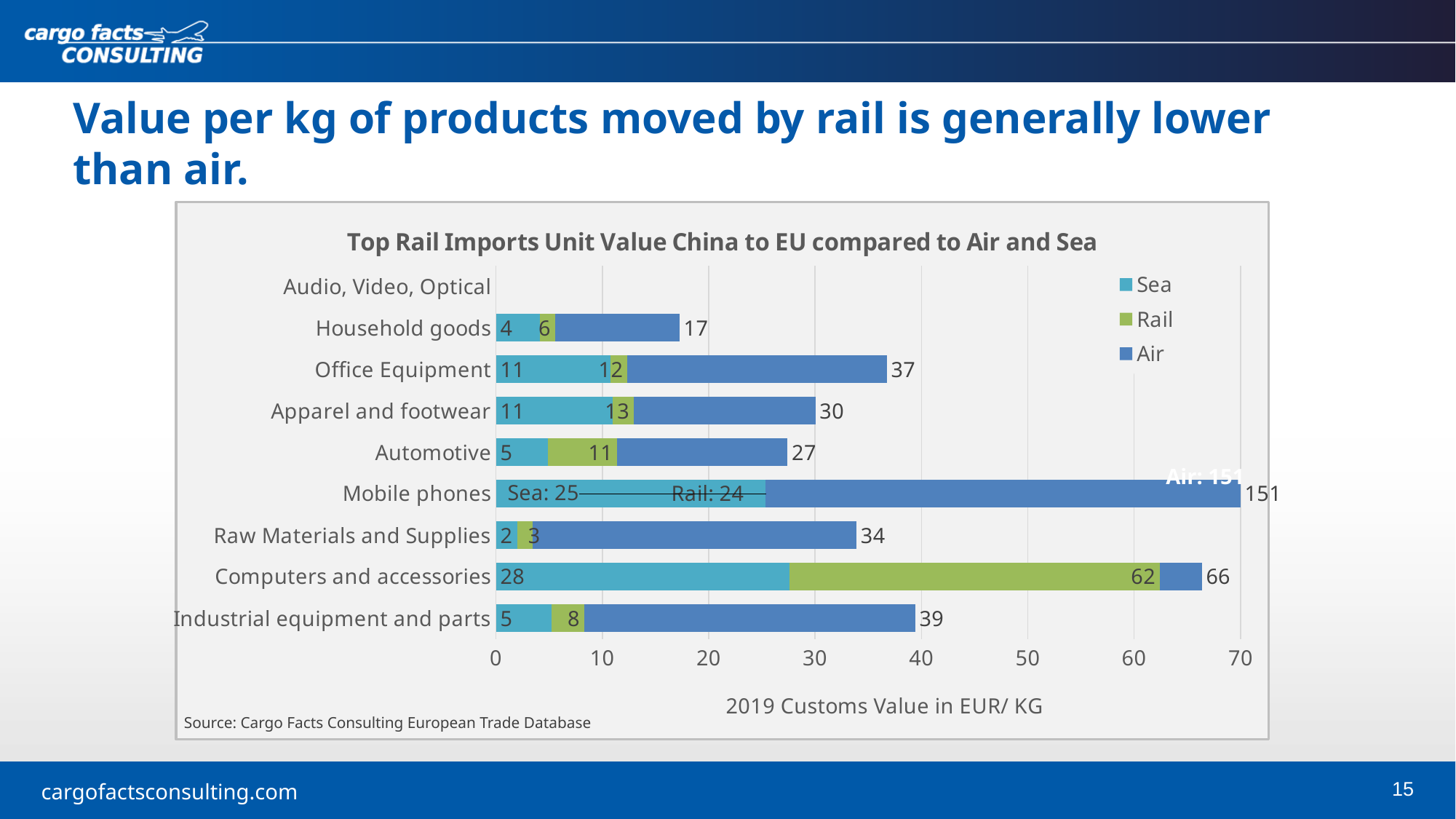
Which is larger for Automotive, the Rail value or the Sea value? Rail Which category has the highest Rail value? Computers and accessories What is the Air value for Mobile phones? 151 Is the Air value for Raw Materials and Supplies greater or less than 30? greater What is the label of the horizontal axis? 2019 Customs Value in EUR/ KG How many series does the legend list? 3 What kind of chart is shown on the slide? Bar chart What is the difference between the Air value and the Rail value for Industrial equipment and parts? 31 What is the Rail value for Computers and accessories? 62 Which category has the lowest Sea value? Raw Materials and Supplies What is the title of the chart? Top Rail Imports Unit Value China to EU compared to Air and Sea What is the Sea value for Office Equipment? 11